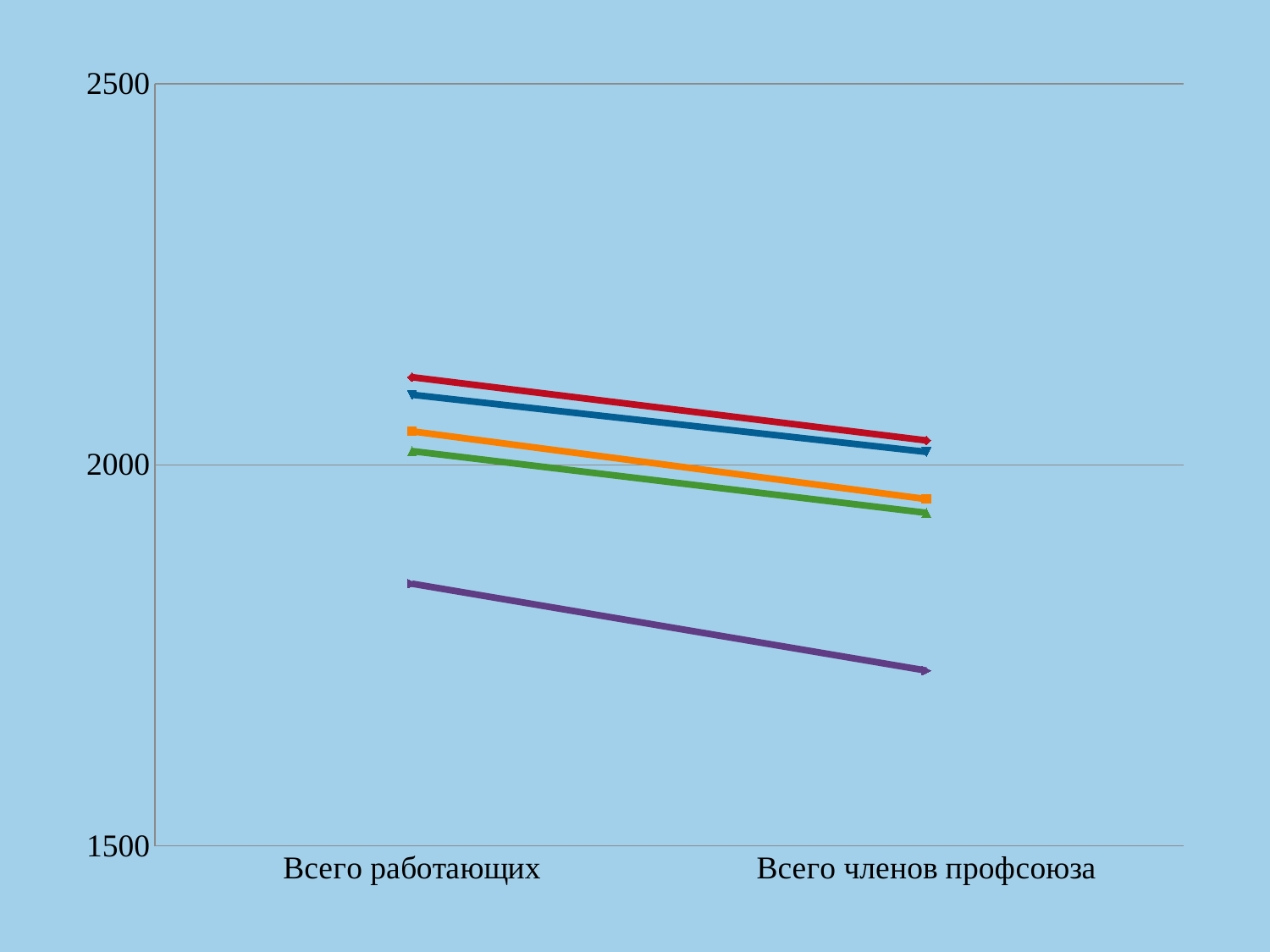
How many categories are shown on the x axis? 2 What kind of chart is shown on the slide? line chart Which line is the lowest on the chart? the purple line Is the value of the red line for "Всего работающих" greater or less than 2000? greater For "Всего членов профсоюза", which is larger: the red line or the purple line? the red line What is the highest value shown on the y axis? 2500 Is the value of the orange line for "Всего членов профсоюза" greater or less than 2000? less Do the lines rise or fall from "Всего работающих" to "Всего членов профсоюза"? fall Is the value of the purple line for "Всего работающих" greater or less than 2000? less Which line is the highest on the chart? the red line How many lines are plotted on the chart? 5